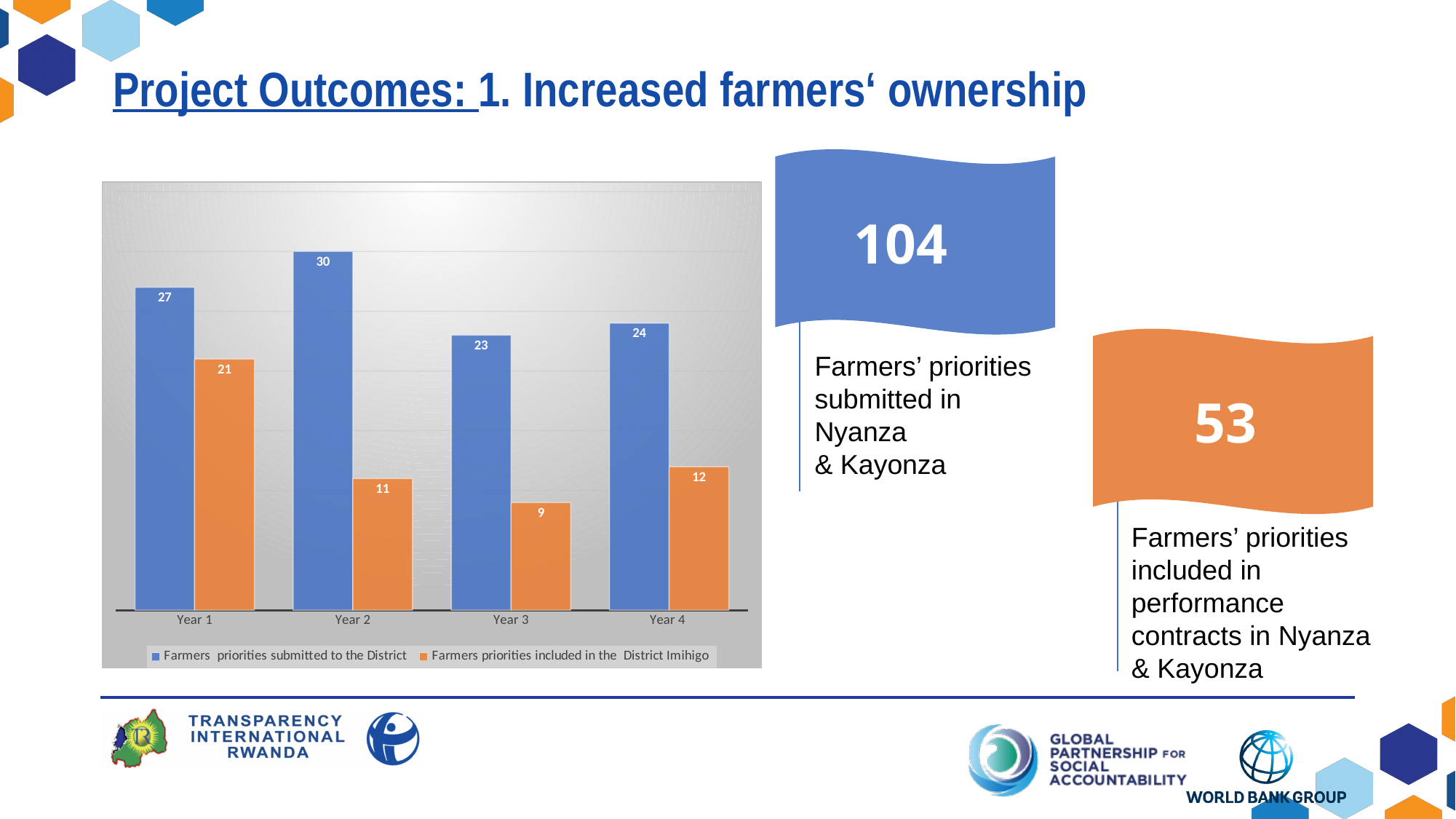
How many series does the chart's legend list? 2 What is the value of farmers' priorities included in the District Imihigo in Year 3? 9 In which year were the fewest farmers' priorities included in the District Imihigo? Year 3 Which is larger: farmers' priorities submitted to the District in Year 1 or in Year 3? Year 1 What kind of chart is shown on the slide? bar chart Do the values for farmers' priorities included in the District Imihigo rise or fall from Year 1 to Year 3? fall In which year were the most farmers' priorities submitted to the District? Year 2 How many year categories are shown on the x axis of the chart? 4 Which colour represents farmers' priorities included in the District Imihigo in the chart? orange What is the value of farmers' priorities included in the District Imihigo in Year 1? 21 What is the difference between farmers' priorities submitted to the District and those included in the District Imihigo in Year 4? 12 What is the value of farmers' priorities submitted to the District in Year 2? 30